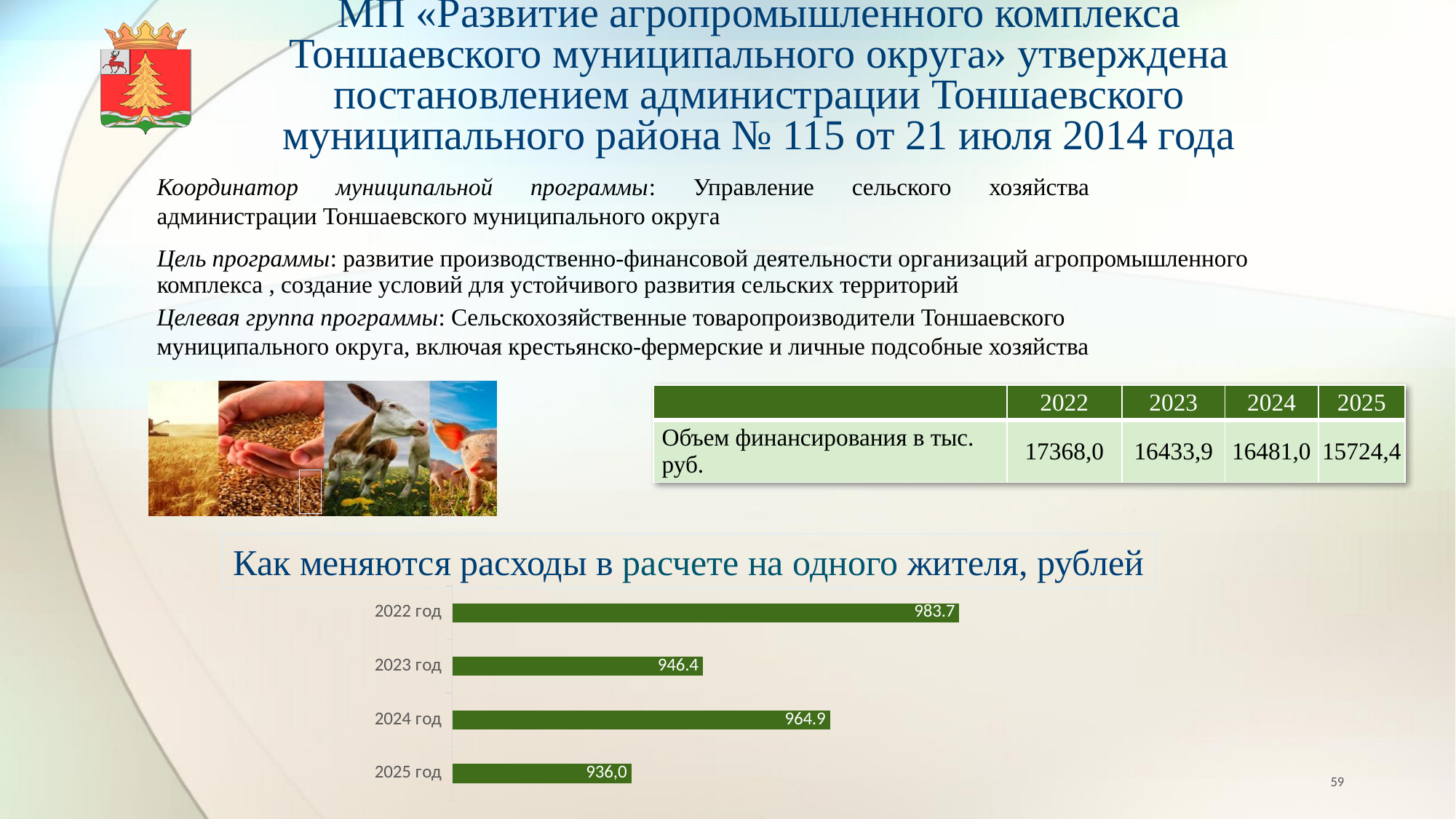
Which is larger, the value for 2023 год or the value for 2024 год? 2024 год What is the value for 2023 год in the chart? 946.4 What is the value for 2025 год in the chart? 936,0 How many years are shown in the chart? 4 Which year has the lowest value in the chart? 2025 год What kind of chart is shown on the slide? bar chart What is the value for 2024 год in the chart? 964.9 What is the difference between the values for 2024 год and 2025 год? 28.9 What is the value for 2022 год in the chart? 983.7 Which year has the highest value in the chart? 2022 год What is the difference between the values for 2022 год and 2023 год? 37.3 What is the title of the chart? Как меняются расходы в расчете на одного жителя, рублей